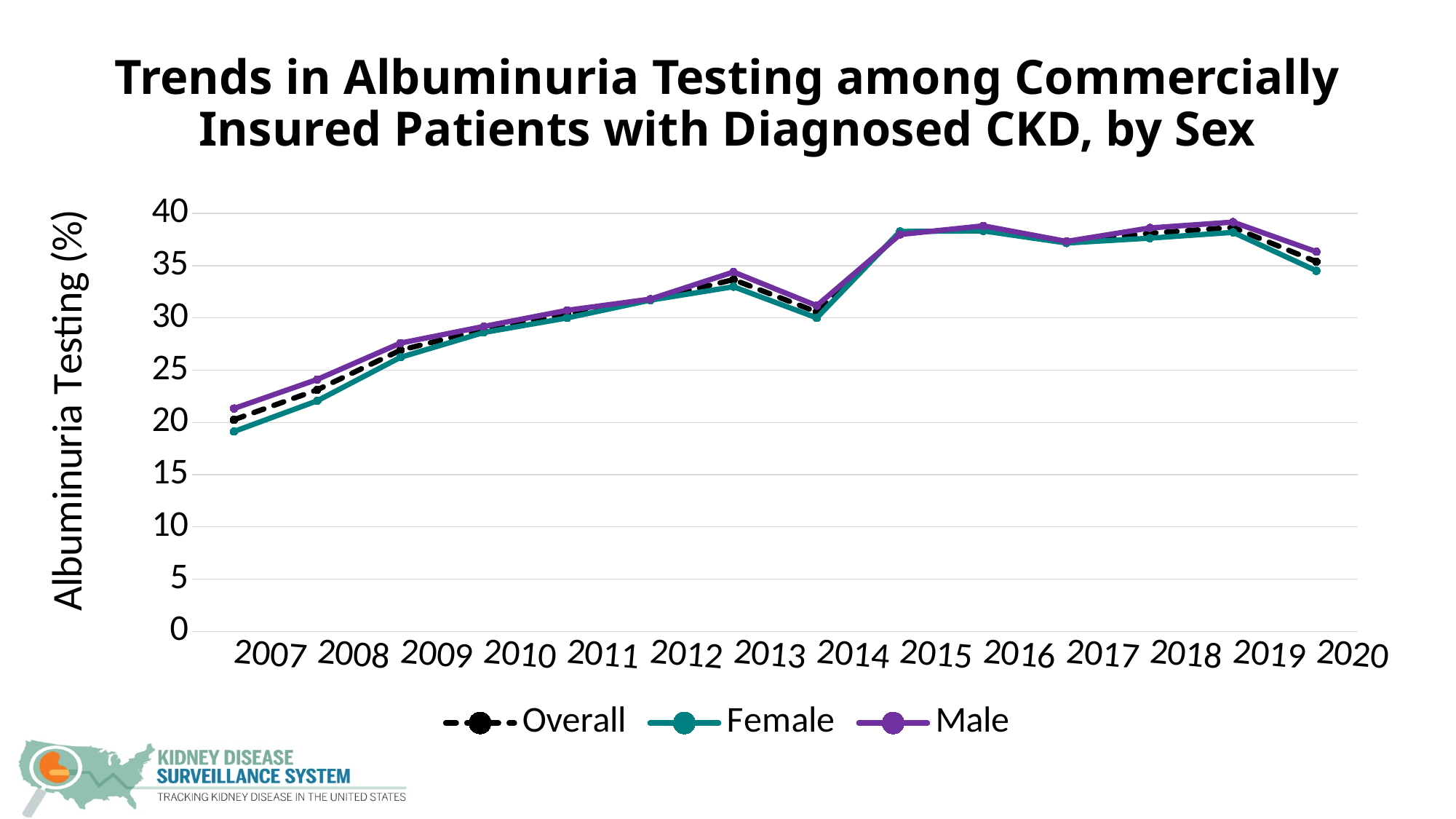
What is the label of the y axis? Albuminuria Testing (%) Is the Female value for 2020 greater or less than 35? less How many series does the legend list? 3 Is the Male value for 2007 greater or less than 20? greater Overall, do the values rise or fall from 2007 to 2020? rise Is the Male value for 2020 greater or less than 35? greater In 2007, which is larger, the Male value or the Female value? Male In which year is the Female value lowest? 2007 How many years are shown on the x axis? 14 What kind of chart is shown on the slide? line chart